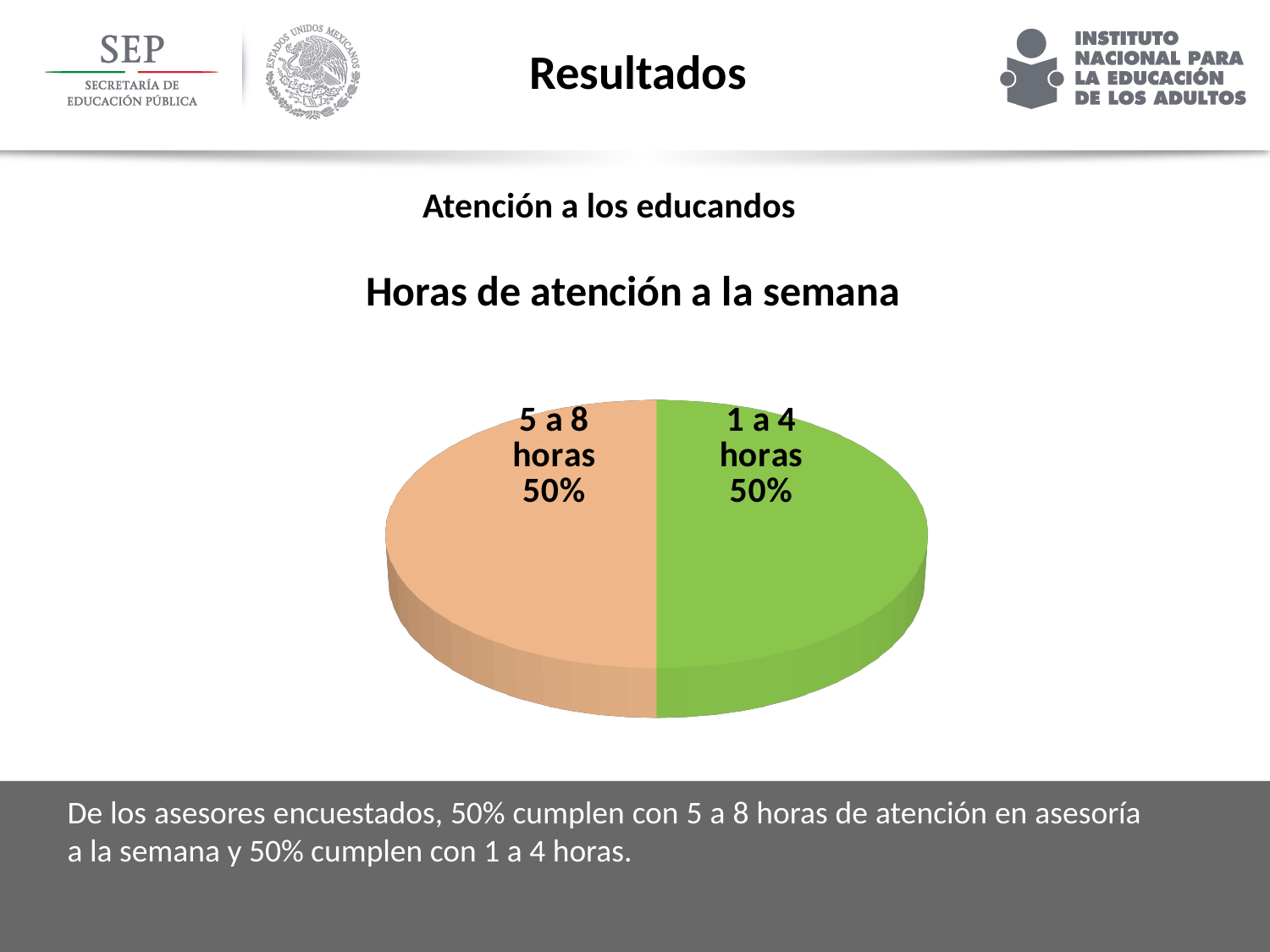
What is the total of the two slices shown in the pie chart? 100% What is the title of the chart? Horas de atención a la semana What share of the pie does the "1 a 4 horas" slice represent? 50% What colour is the "1 a 4 horas" slice? green How many slices does the pie chart have? 2 What kind of chart is shown on the slide? pie chart What is the difference between the "5 a 8 horas" share and the "1 a 4 horas" share? 0% What share of the pie does the "5 a 8 horas" slice represent? 50%